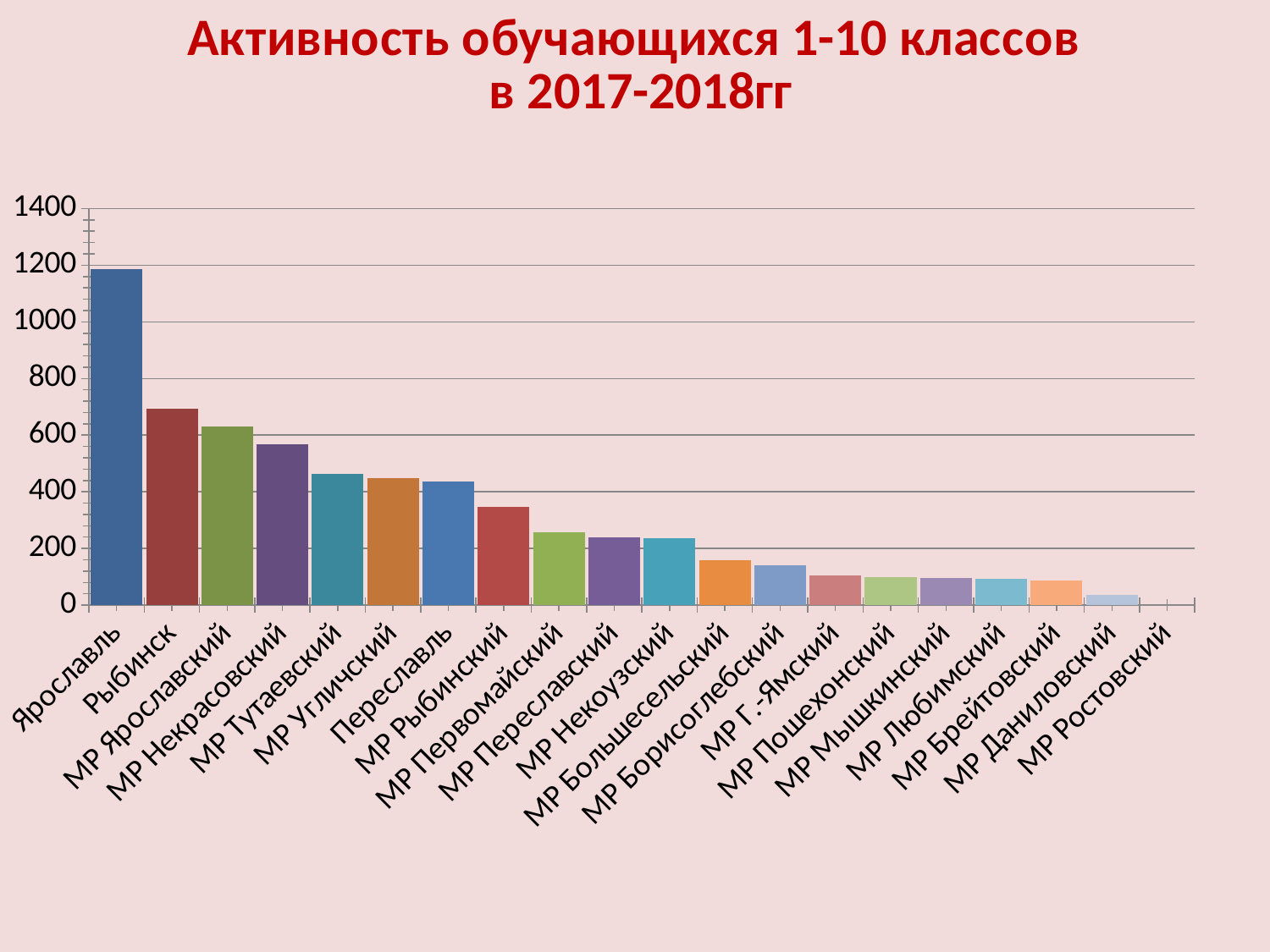
Which category has the highest value in the chart? Ярославль Which is larger, the value for МР Тутаевский or the value for МР Рыбинский? МР Тутаевский Is the value for МР Рыбинский greater or less than 400? less What is the title of the chart? Активность обучающихся 1-10 классов в 2017-2018гг Is the value for МР Некрасовский greater or less than 600? less Which is larger, the value for Рыбинск or the value for МР Ярославский? Рыбинск What kind of chart is shown on the slide? bar chart How many categories are shown on the x axis of the chart? 20 Do the values rise or fall moving from left to right along the x axis? fall Is the value for МР Большесельский greater or less than 200? less